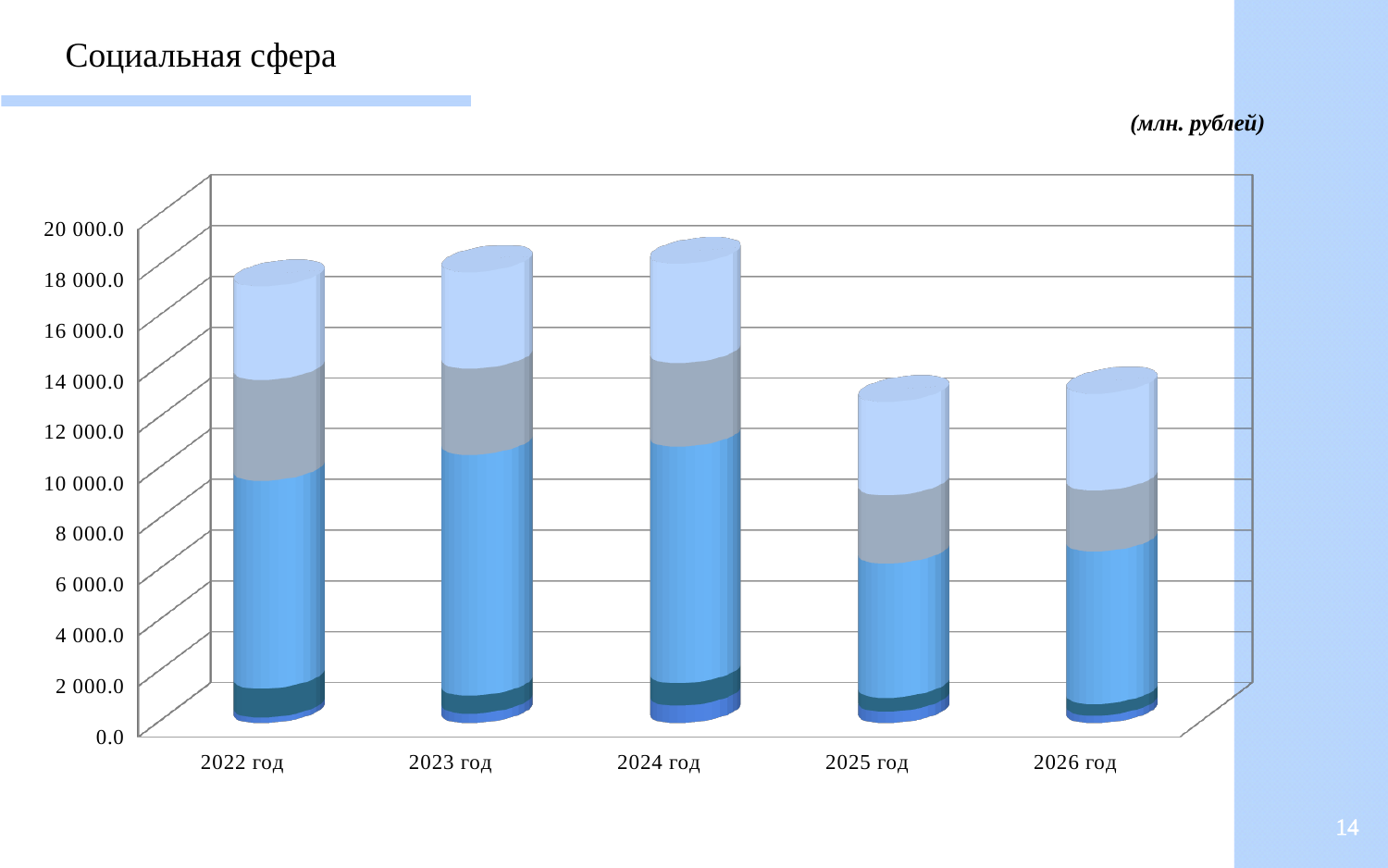
How many years (categories) are shown on the x axis of the chart? 5 In what units are the values on the chart expressed, according to the note on the slide? млн. рублей Do the total bar heights rise or fall from 2024 год to 2025 год? fall What type of chart is shown on the slide? Stacked bar chart What is the highest value shown on the vertical axis of the chart? 20 000.0 Is the total bar for 2026 год greater or less than 16 000.0? less Which year has the lowest total bar on the chart, 2022 год or 2025 год? 2025 год Is the total bar for 2025 год greater or less than 16 000.0? less Is the total bar for 2024 год greater or less than 14 000.0? greater Which bar is taller, 2024 год or 2026 год? 2024 год What is the title of the slide containing the chart? Социальная сфера